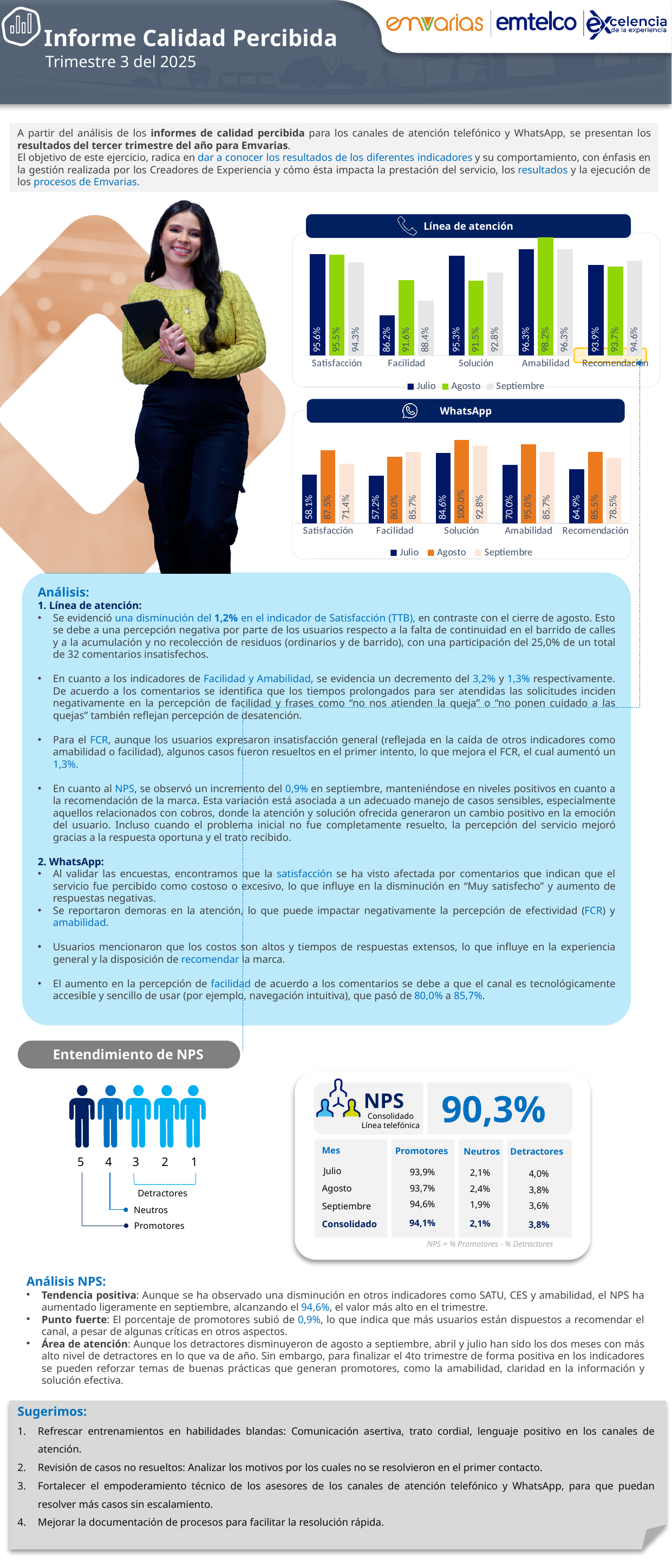
In the 'Línea de atención' chart, what is the value for Satisfacción in Julio? 95,6% In the 'Línea de atención' chart, what is the value for Amabilidad in Agosto? 98,2% In the 'WhatsApp' chart, which category has the highest value in Septiembre? Solución In the 'Línea de atención' chart, which category has the lowest value in Julio? Facilidad How many categories are shown on the x axis of the 'WhatsApp' chart? 5 In the 'WhatsApp' chart, what is the difference between the Agosto and Julio values for Solución? 15,4 percentage points In the 'WhatsApp' chart, which is larger for Facilidad: the Agosto value or the Septiembre value? Septiembre In the 'Línea de atención' chart, how many series does the legend list? 3 In the 'WhatsApp' chart, what is the value for Satisfacción in Julio? 58,1% What type of chart is the 'Línea de atención' chart? Bar chart In the 'WhatsApp' chart, what is the value for Solución in Agosto? 100,0% In the 'Línea de atención' chart, what is the difference between the Agosto and Julio values for Facilidad? 5,4 percentage points